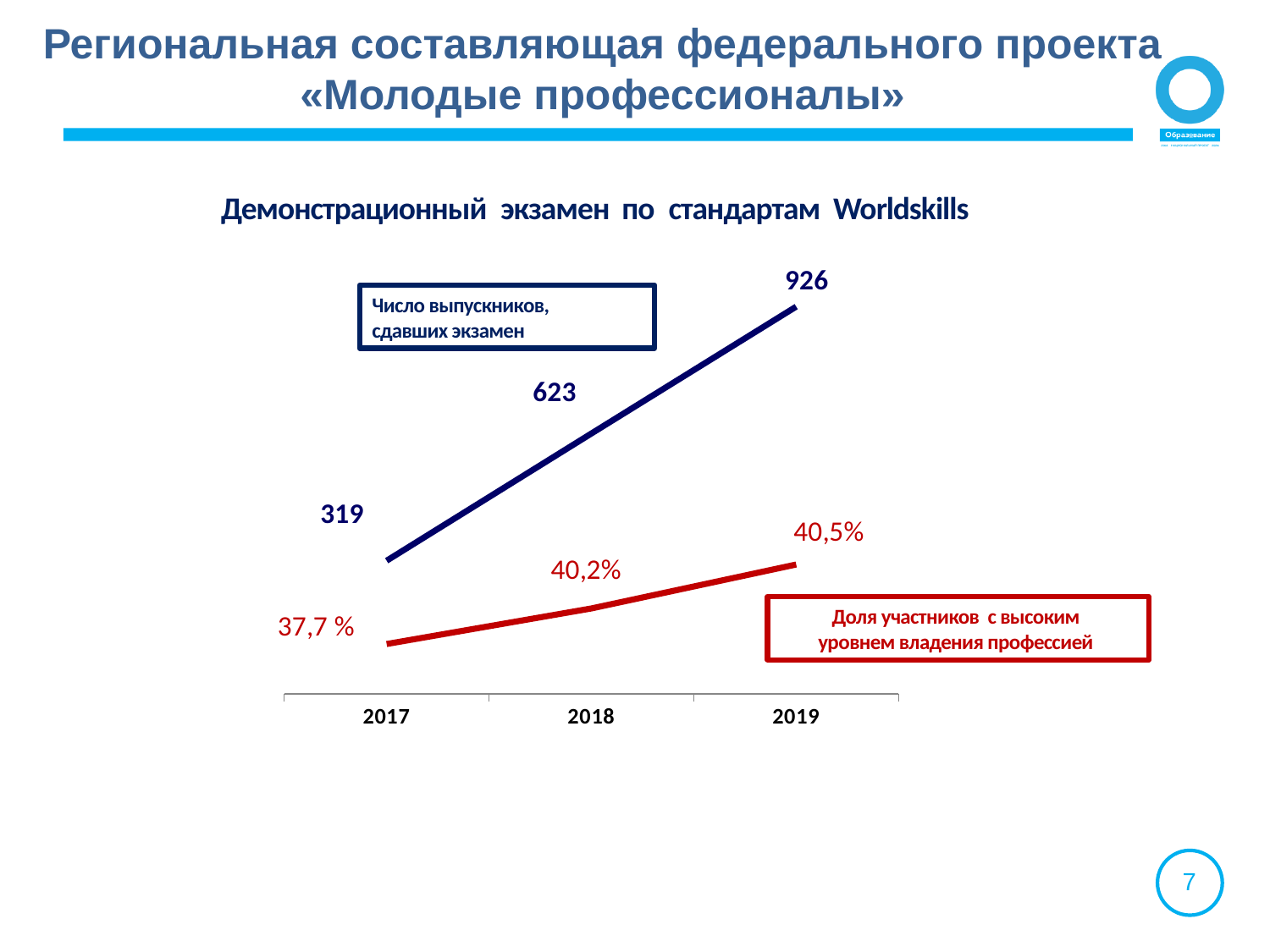
In which year was the share of participants with a high level of professional skill the lowest? 2017 Does the number of graduates who passed the exam rise or fall from 2017 to 2019? Rise What is the share of participants with a high level of professional skill (Доля участников с высоким уровнем владения профессией) in 2017? 37,7 % What is the share of participants with a high level of professional skill (Доля участников с высоким уровнем владения профессией) in 2019? 40,5% In which year was the number of graduates who passed the exam the highest? 2019 By how much did the number of graduates who passed the exam increase from 2017 to 2019? 607 What is the number of graduates who passed the exam (Число выпускников, сдавших экзамен) in 2018? 623 Which year had more graduates who passed the exam, 2017 or 2018? 2018 What kind of chart is shown on the slide? Line chart What is the number of graduates who passed the exam (Число выпускников, сдавших экзамен) in 2017? 319 What is the number of graduates who passed the exam (Число выпускников, сдавших экзамен) in 2019? 926 How many years are shown on the x axis of the chart? 3